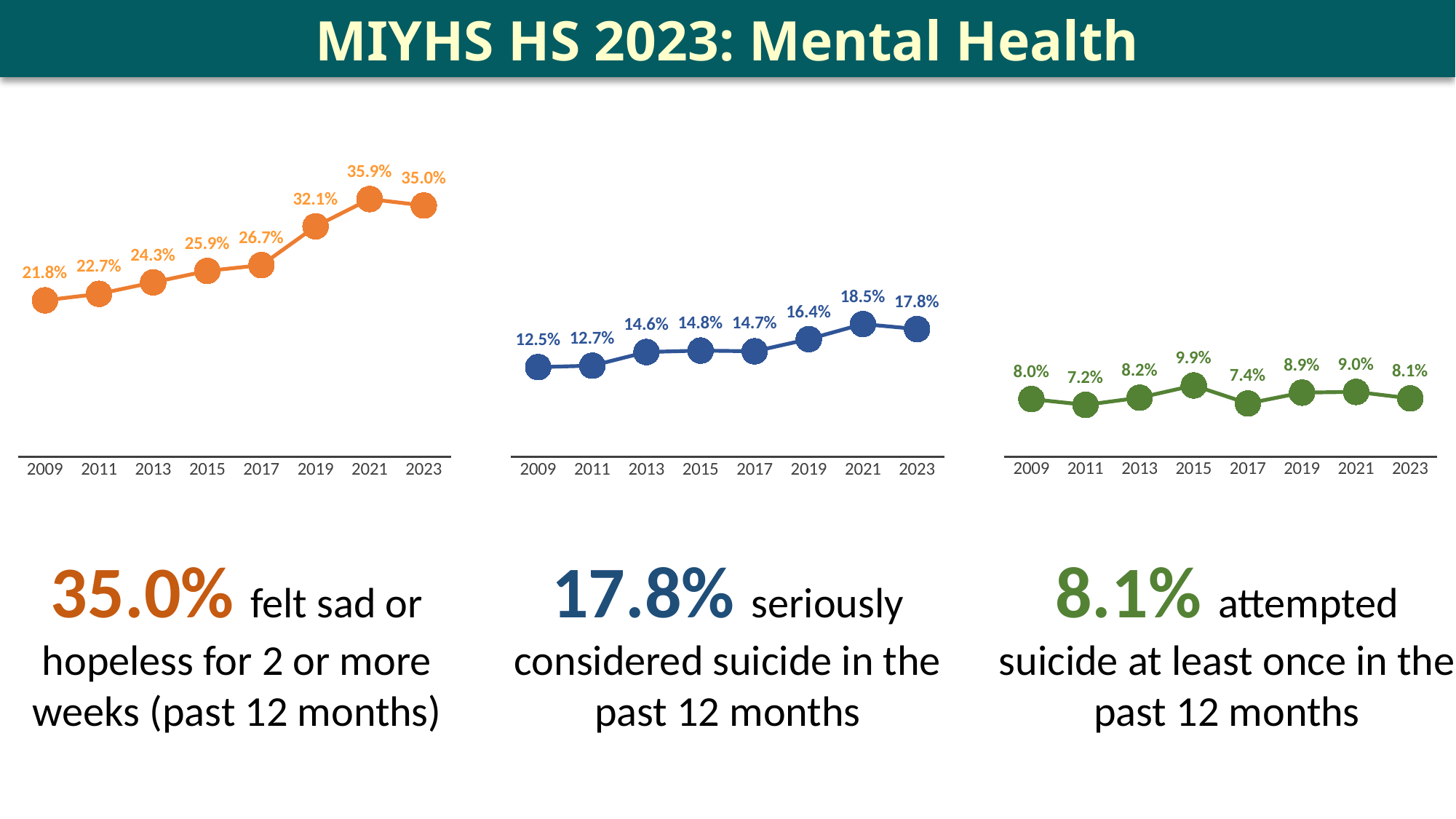
In the left (orange) chart, what was the value in 2019? 32.1% In the left (orange) chart, what is the difference between the 2023 value and the 2009 value? 13.2 percentage points In the right (green) chart, what is the difference between the 2015 value and the 2017 value? 2.5 percentage points In the middle (blue) chart, is the value for 2021 larger or smaller than the value for 2023? larger What type of chart is the middle (blue) chart? Line chart How many data points are plotted in the left (orange) chart? 8 In the middle (blue) chart, which year has the lowest value? 2009 In the left (orange) chart, which year has the highest value? 2021 In the right (green) chart, what was the value in 2015? 9.9% In the middle (blue) chart, what was the value in 2013? 14.6% In the right (green) chart, which year has the lowest value? 2011 In the left (orange) chart, do the values generally rise or fall from 2009 to 2021? Rise